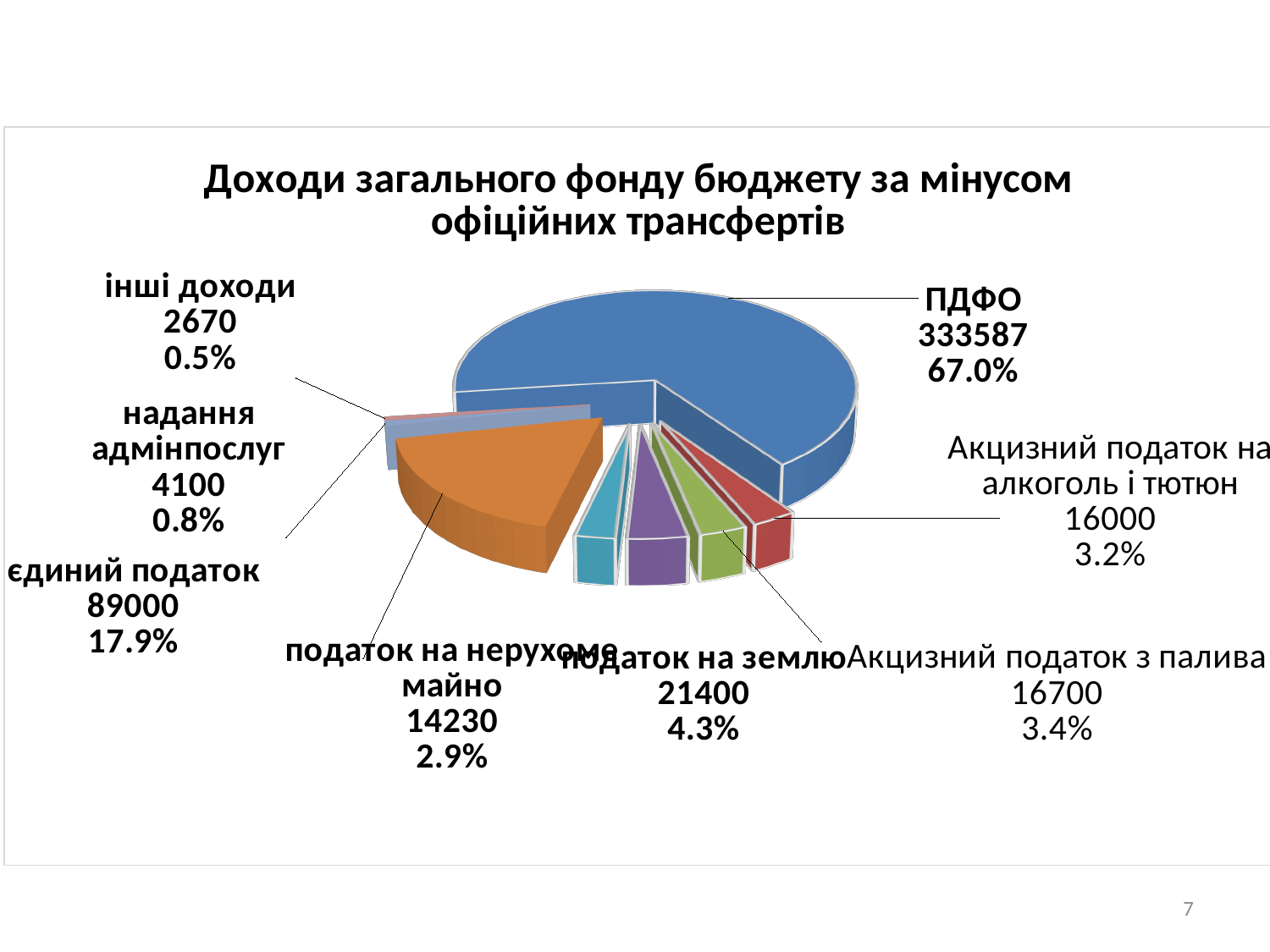
Which category has the smallest slice? інші доходи What is the value for ПДФО? 333587 What is the title of the chart? Доходи загального фонду бюджету за мінусом офіційних трансфертів What is the value for єдиний податок? 89000 What share of the pie does ПДФО represent? 67.0% Which is larger: податок на землю or податок на нерухоме майно? податок на землю What kind of chart is shown on the slide? Pie chart What is the difference between the values for Акцизний податок з палива and Акцизний податок на алкоголь і тютюн? 700 What is the value for надання адмінпослуг? 4100 What share of the pie does податок на землю represent? 4.3% How many categories (slices) does the pie chart have? 8 Which category has the largest slice? ПДФО